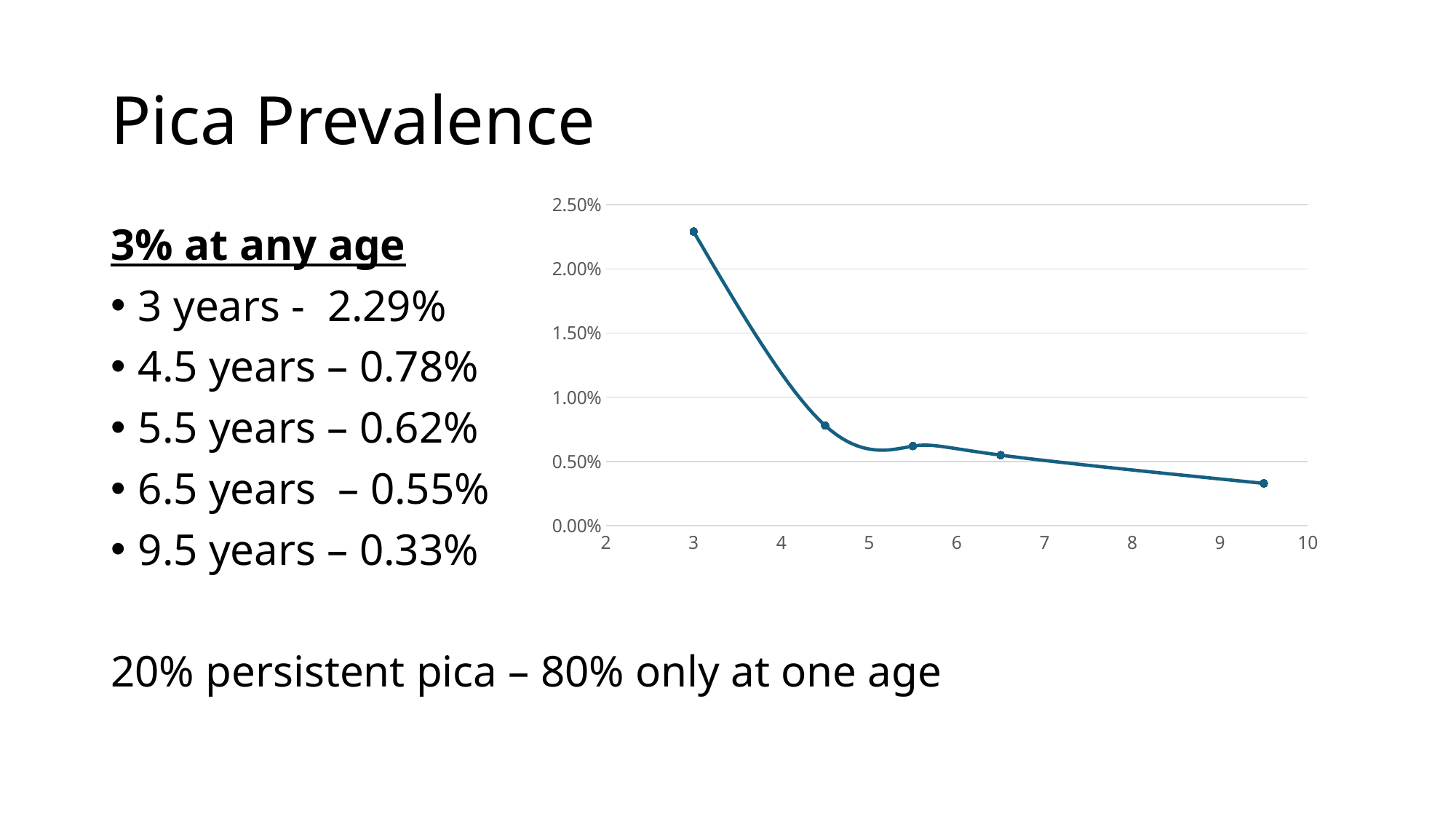
What kind of chart is shown on the slide? line chart Is the plotted value at age 3 greater or less than 2.00%? greater What is the pica prevalence at 3 years, as stated on the slide? 2.29% What is the difference between the prevalence at 3 years (2.29%) and at 9.5 years (0.33%)? 1.96% Is the plotted value at age 9.5 greater or less than 0.50%? less Which has the larger plotted value, age 4.5 or age 6.5? age 4.5 What is the highest tick label shown on the chart's vertical axis? 2.50% At which age is the plotted pica prevalence highest? 3 How many data points are plotted on the line chart? 5 At which age is the plotted pica prevalence lowest? 9.5 Do the plotted values rise or fall as age increases along the x axis? fall Is the plotted value at age 4.5 greater or less than 1.00%? less